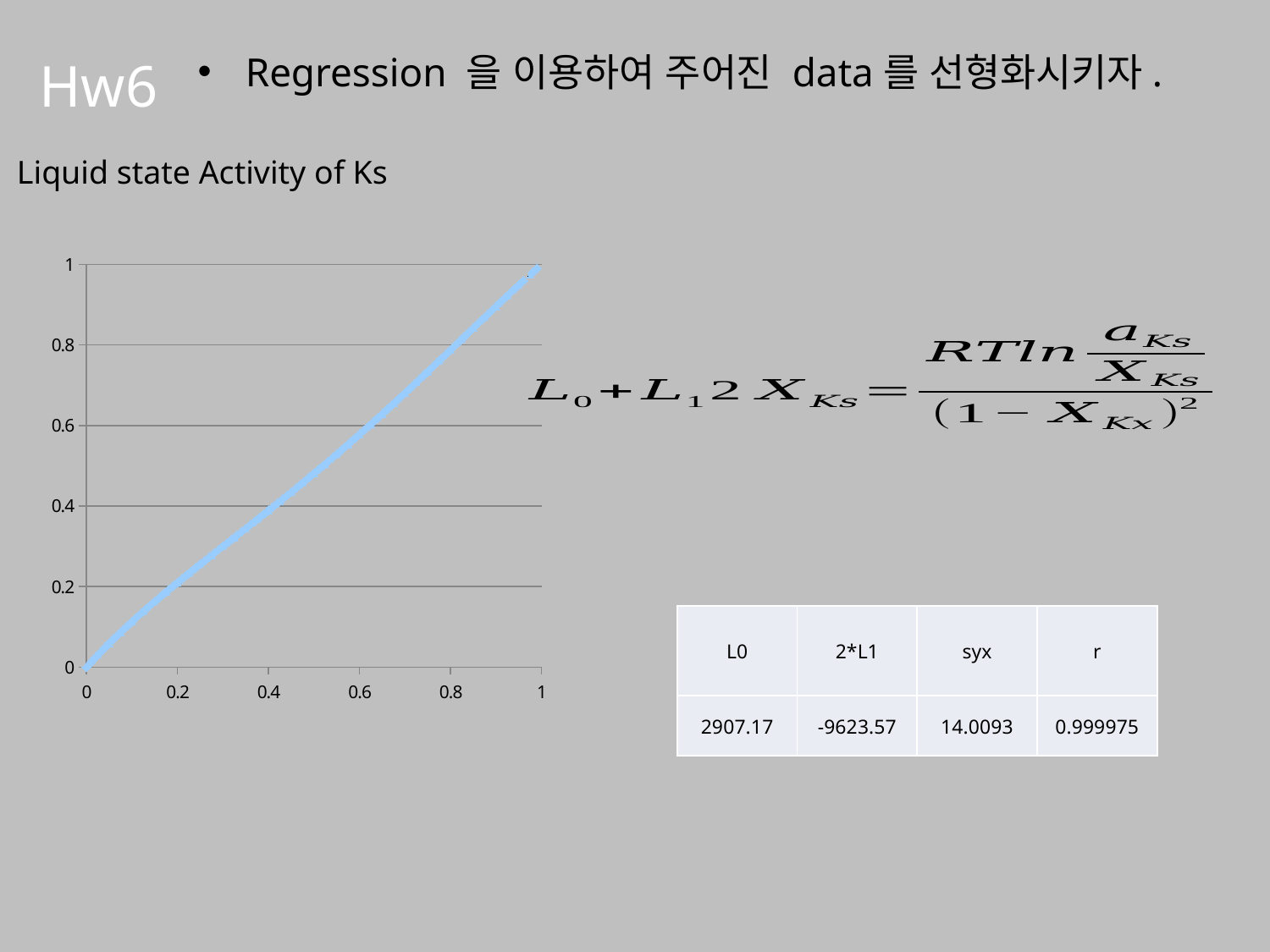
What kind of chart is shown on the slide? line chart Do the plotted values rise or fall as the x axis increases from 0 to 1? rise Is the plotted value at x = 0.8 greater or less than 0.6? greater Is the plotted value at x = 0.2 greater or less than 0.4? less Is the plotted value at x = 0.6 greater or less than 0.4? greater What is the lowest value shown on the x axis of the chart? 0 What is the highest value shown on the y axis of the chart? 1